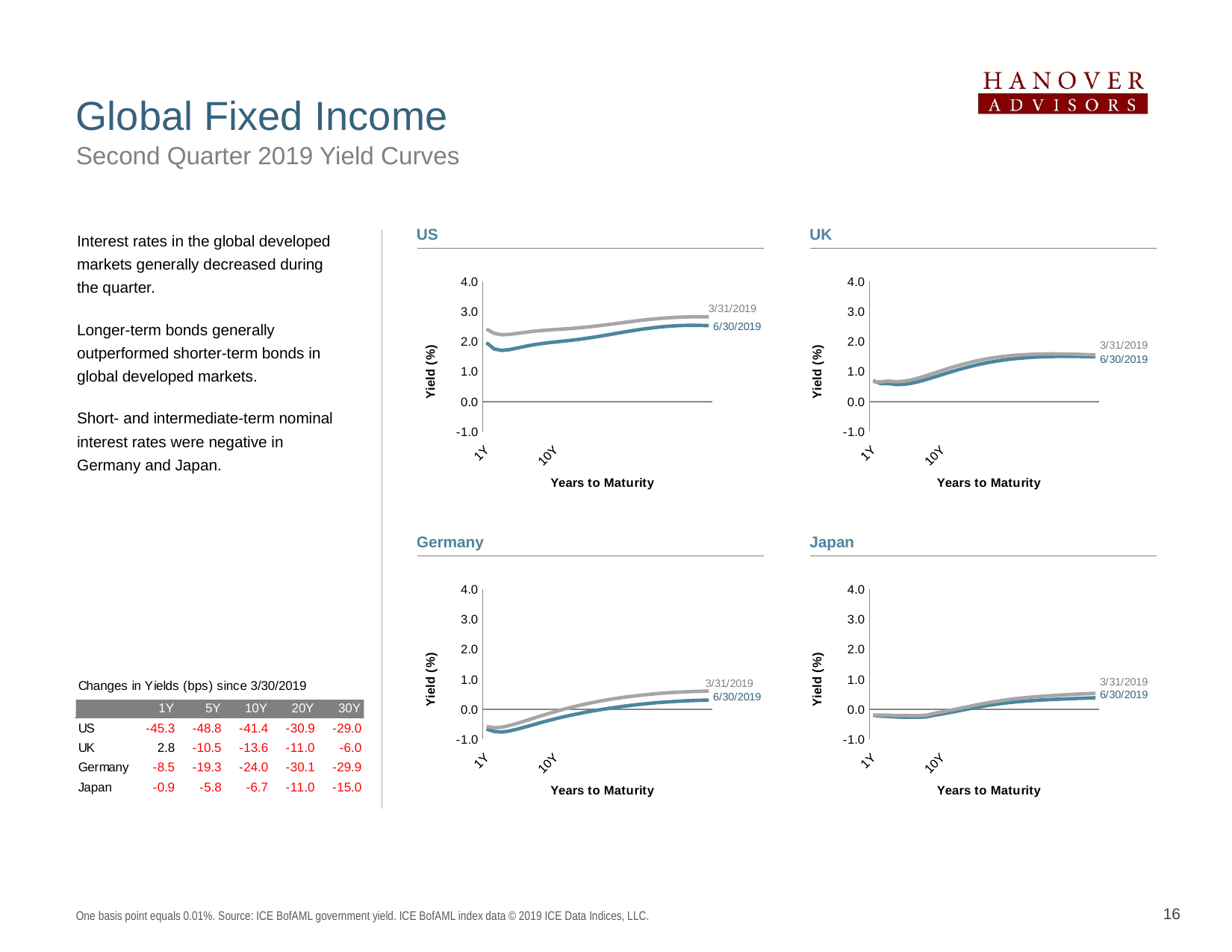
In the Germany chart, is the 6/30/2019 yield at 1Y greater or less than 0.0? less In the Germany chart, which series is higher at 10Y, 3/31/2019 or 6/30/2019? 3/31/2019 In the Japan chart, is the 3/31/2019 yield at 1Y greater or less than 0.0? less In the US chart, do the yields rise or fall as years to maturity increase? rise In the US chart, which series is higher at 1Y, 3/31/2019 or 6/30/2019? 3/31/2019 What is the y-axis title of the Japan chart? Yield (%) How many yield curve charts are shown on the slide? 4 In the US chart, is the 3/31/2019 yield at 1Y greater or less than 2.0? greater In the Germany chart, do the yields rise or fall as years to maturity increase? rise What kind of chart is the US chart? line chart